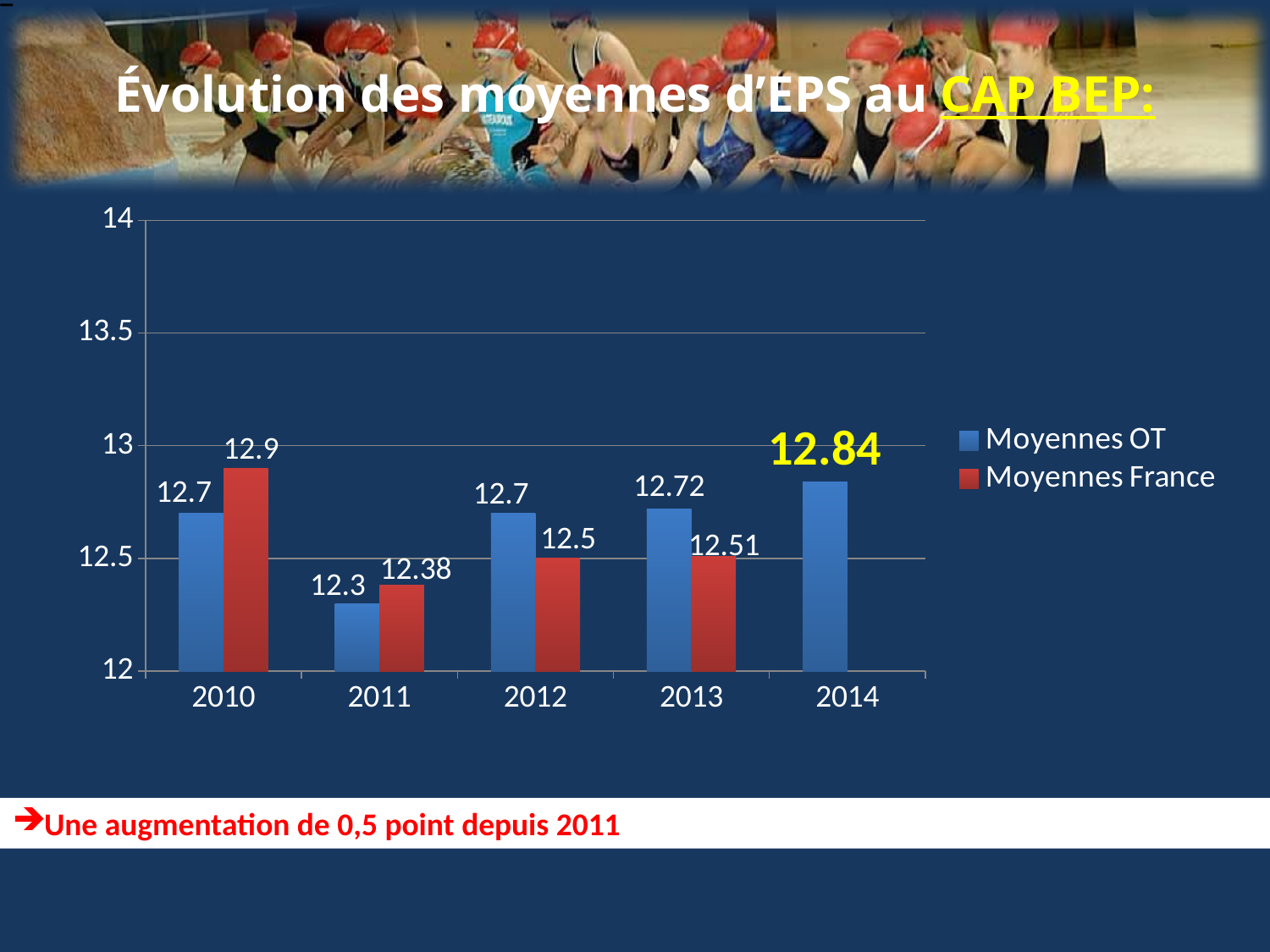
Which year has the lowest value for Moyennes OT? 2011 What kind of chart is shown on the slide? bar chart Is the value of Moyennes OT for 2014 greater or less than 13? less What is the value of Moyennes OT for 2014? 12.84 What is the difference between Moyennes France and Moyennes OT in 2010? 0.2 What is the value of Moyennes OT for 2011? 12.3 What is the value of Moyennes France for 2010? 12.9 Which is larger in 2013, Moyennes OT or Moyennes France? Moyennes OT How many years are shown on the x axis? 5 What is the value of Moyennes France for 2013? 12.51 Which year has the highest value for Moyennes France? 2010 How many series does the legend list? 2